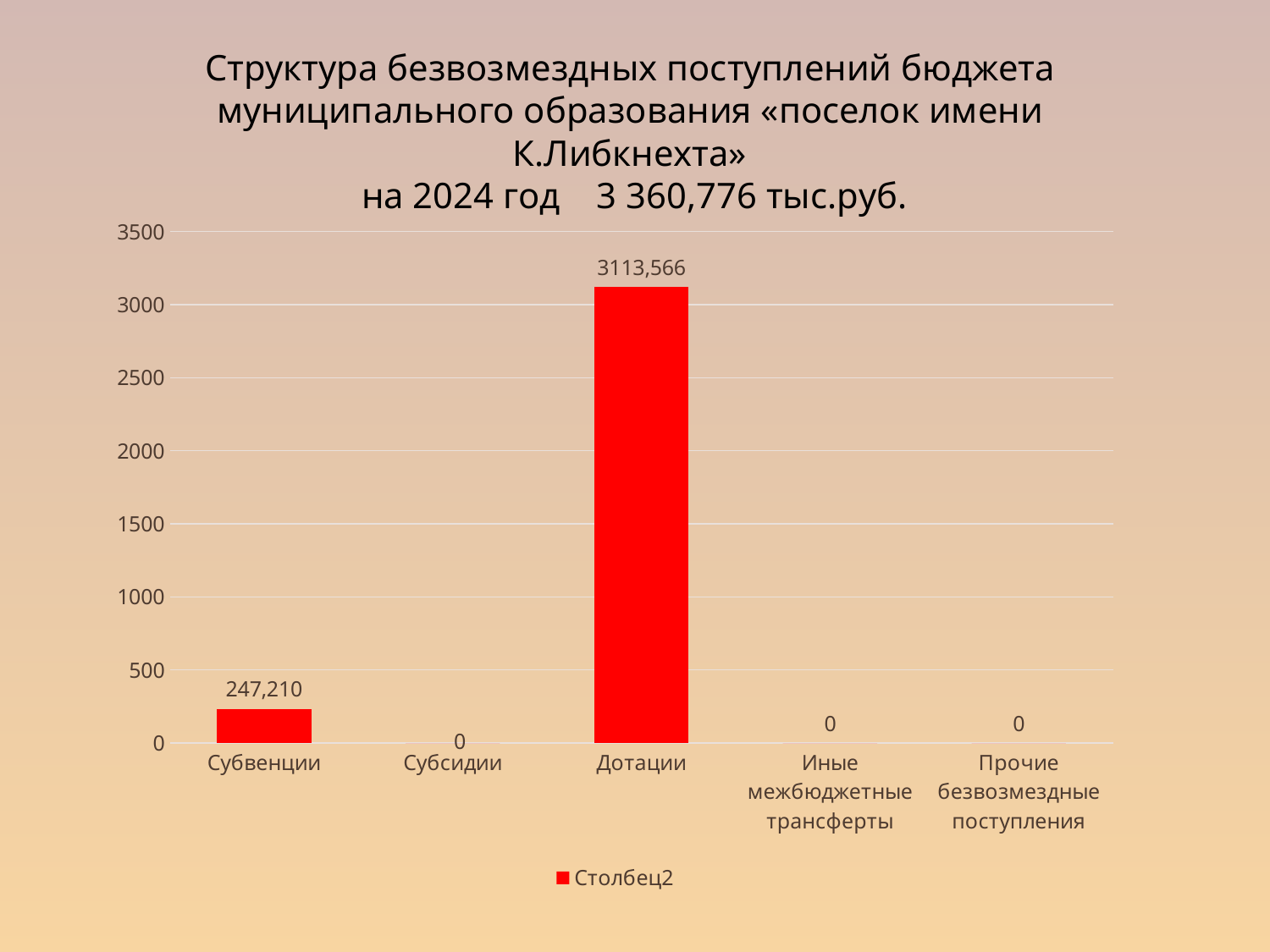
What kind of chart is shown on the slide? bar chart What is the value for Иные межбюджетные трансферты? 0 What is the value for Дотации? 3113,566 What is the difference between the values for Дотации and Субвенции? 2866,356 What is the value for Субсидии? 0 Which category has the highest value? Дотации How many categories are shown on the x axis? 5 What is the value for Субвенции? 247,210 Is the value for Дотации greater or less than 3000? greater What series name does the legend show? Столбец2 Which is larger, the value for Субвенции or the value for Дотации? Дотации Is the value for Субвенции greater or less than 500? less